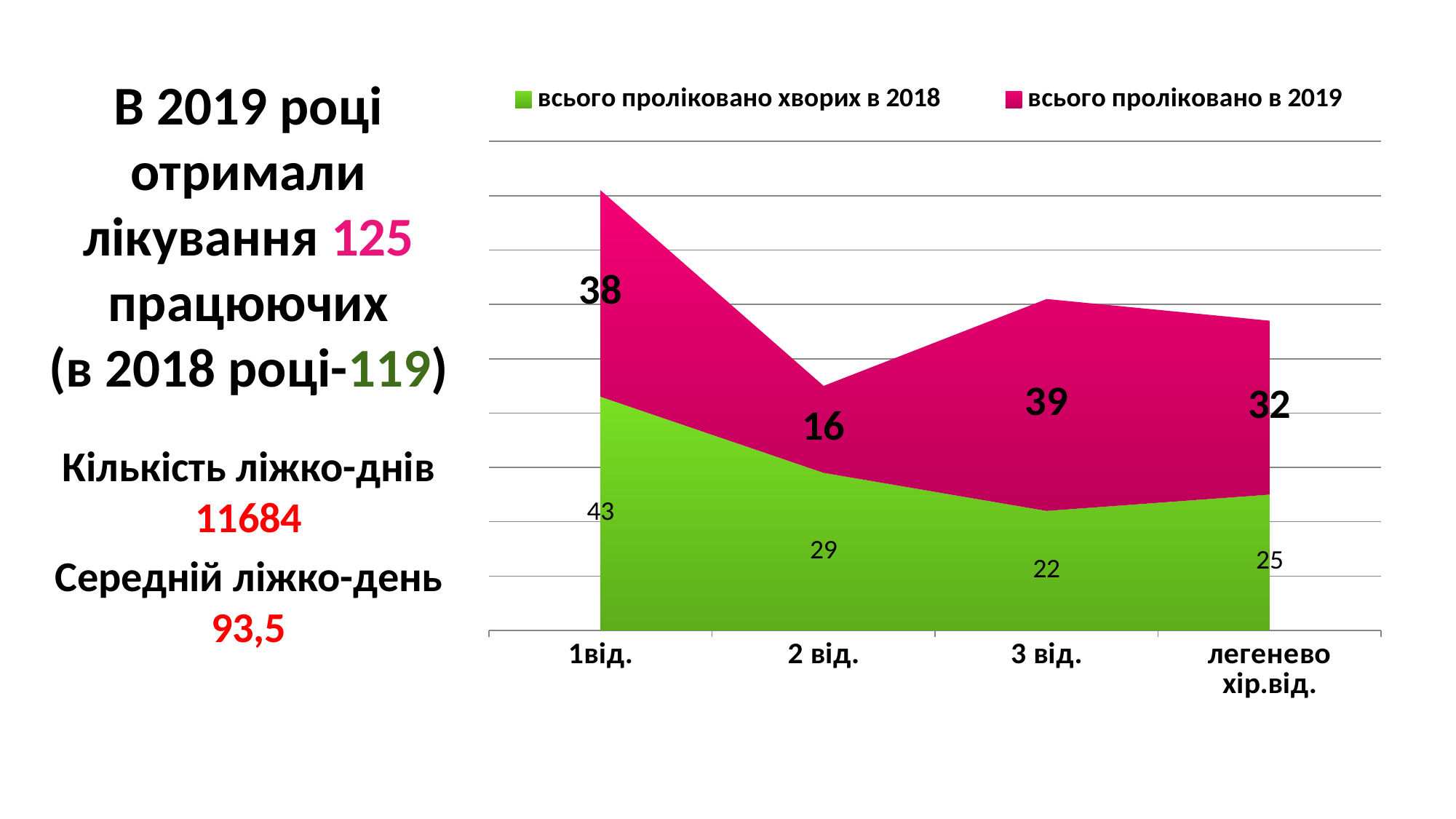
Which category has the highest value for "всього проліковано хворих в 2018"? 1від. What is the value for "всього проліковано хворих в 2018" at "1від."? 43 How many categories are shown on the x axis? 4 Which category has the lowest value for "всього проліковано в 2019"? 2 від. How many series does the legend list? 2 Which colour represents "всього проліковано в 2019" in the chart? pink (magenta) What type of chart is shown on the slide? stacked area chart What is the value for "всього проліковано в 2019" at "легенево хір.від."? 32 What is the value for "всього проліковано в 2019" at "3 від."? 39 What is the combined total of the two series at "1від."? 81 Which is larger at "2 від.": the 2018 value or the 2019 value? 2018 value (29) What is the difference between the 2019 and 2018 values at "3 від."? 17